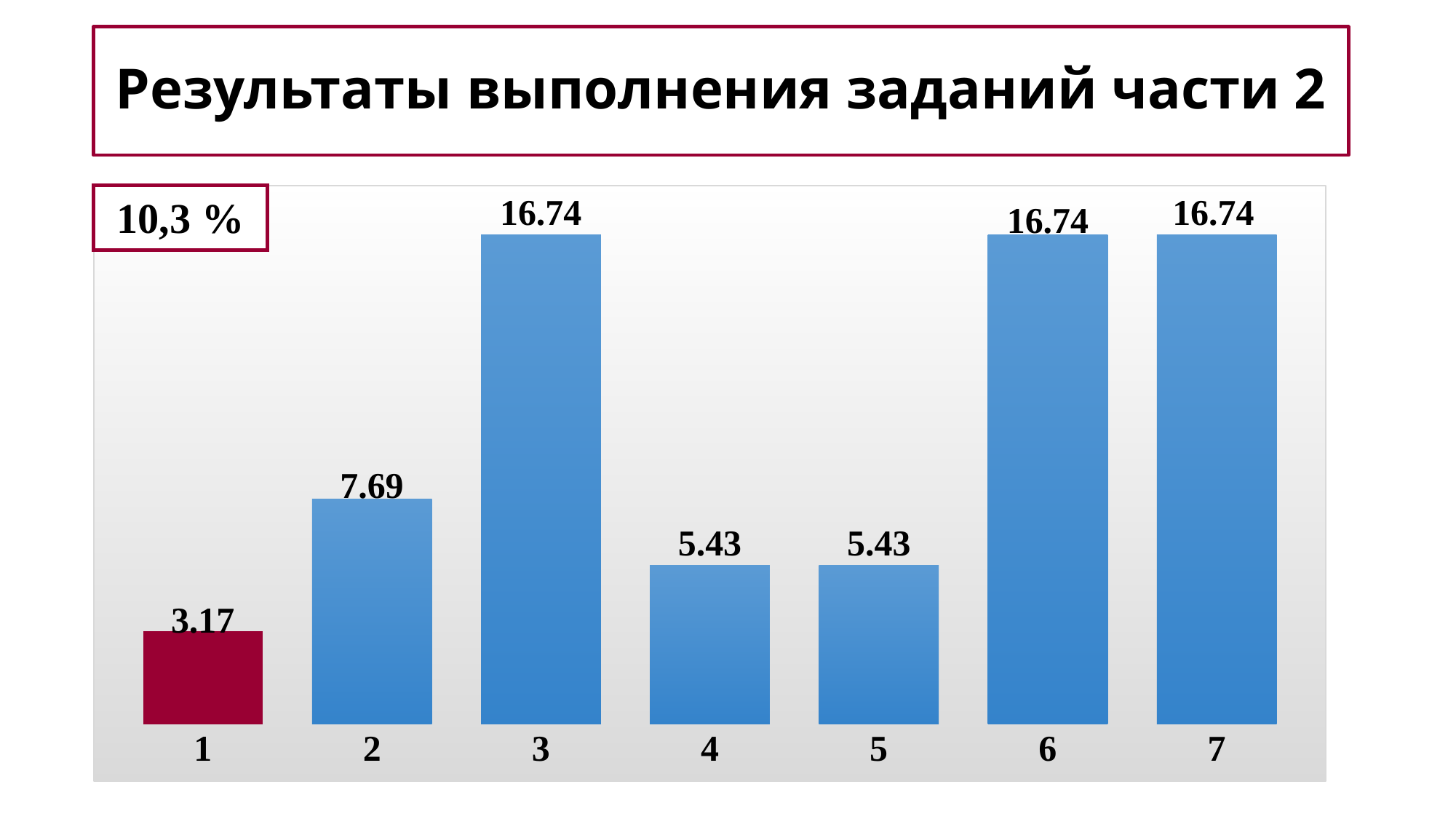
What is the difference between the values for category 3 and category 2? 9.05 What is the value for category 2? 7.69 Which category has the lowest value? 1 How many categories are shown on the chart? 7 What is the value for category 6? 16.74 What kind of chart is shown on the slide? bar chart Which bar is coloured differently from the others? category 1 Which is larger, the value for category 2 or the value for category 5? category 2 What is the value for category 1? 3.17 What is the difference between the values for category 2 and category 1? 4.52 What is the value for category 4? 5.43 What is the highest value shown on the chart? 16.74